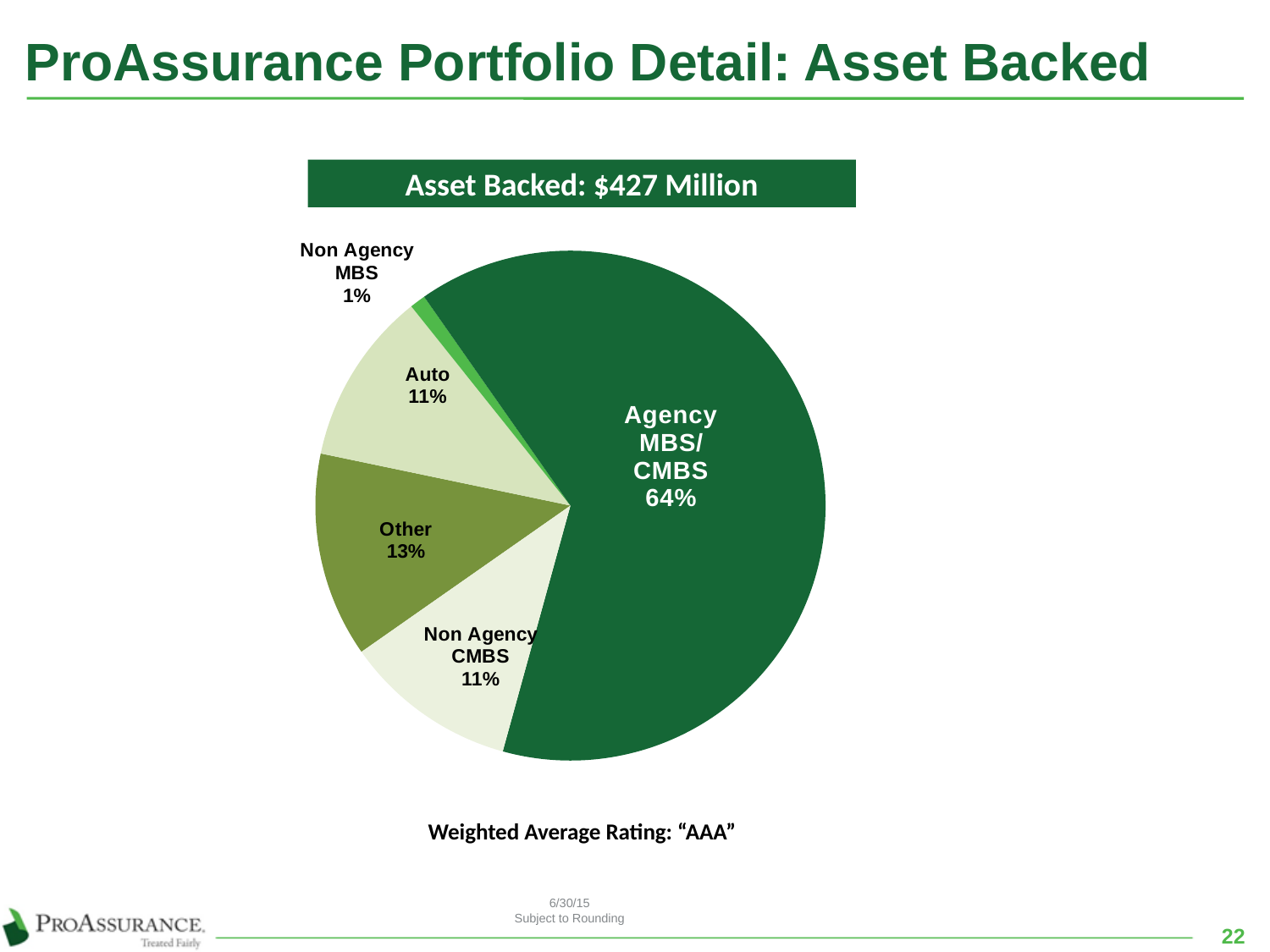
What share of the Asset Backed portfolio is Other? 13% What is the weighted average rating stated below the chart? "AAA" What share of the Asset Backed portfolio is Non Agency MBS? 1% What is the total value of the Asset Backed portfolio shown in the chart title? $427 Million What share of the Asset Backed portfolio is Auto? 11% Which category has the largest share of the pie? Agency MBS/CMBS What type of chart is shown on the slide? pie chart Which is larger, the share for Other or the share for Non Agency CMBS? Other How many slices does the pie chart have? 5 What is the difference in percentage points between Agency MBS/CMBS and Other? 51 Which category has the smallest share of the pie? Non Agency MBS